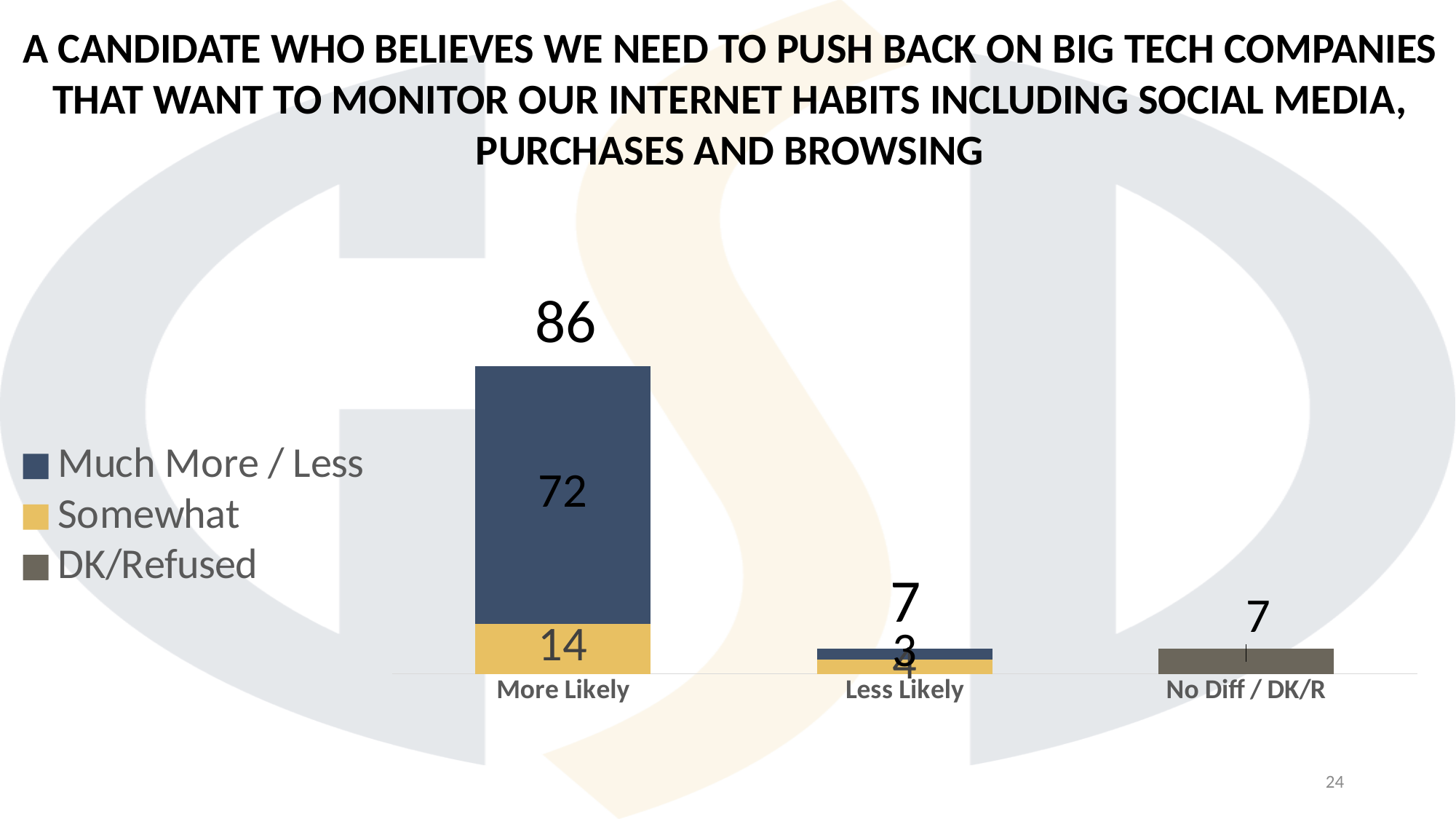
What is the total of the stacked bar for Less Likely? 7 What is the total of the stacked bar for More Likely? 86 How many categories are shown on the x axis? 3 How many series does the legend list? 3 What is the value of the Somewhat segment for More Likely? 14 What is the value of the Much More / Less segment for Less Likely? 3 Which is larger, the total for More Likely or the total for Less Likely? More Likely What is the value of the Much More / Less segment for More Likely? 72 What is the difference between the More Likely total and the Less Likely total? 79 What is the difference between the Much More / Less and Somewhat segments for More Likely? 58 Which category has the highest total? More Likely What is the value shown for No Diff / DK/R? 7